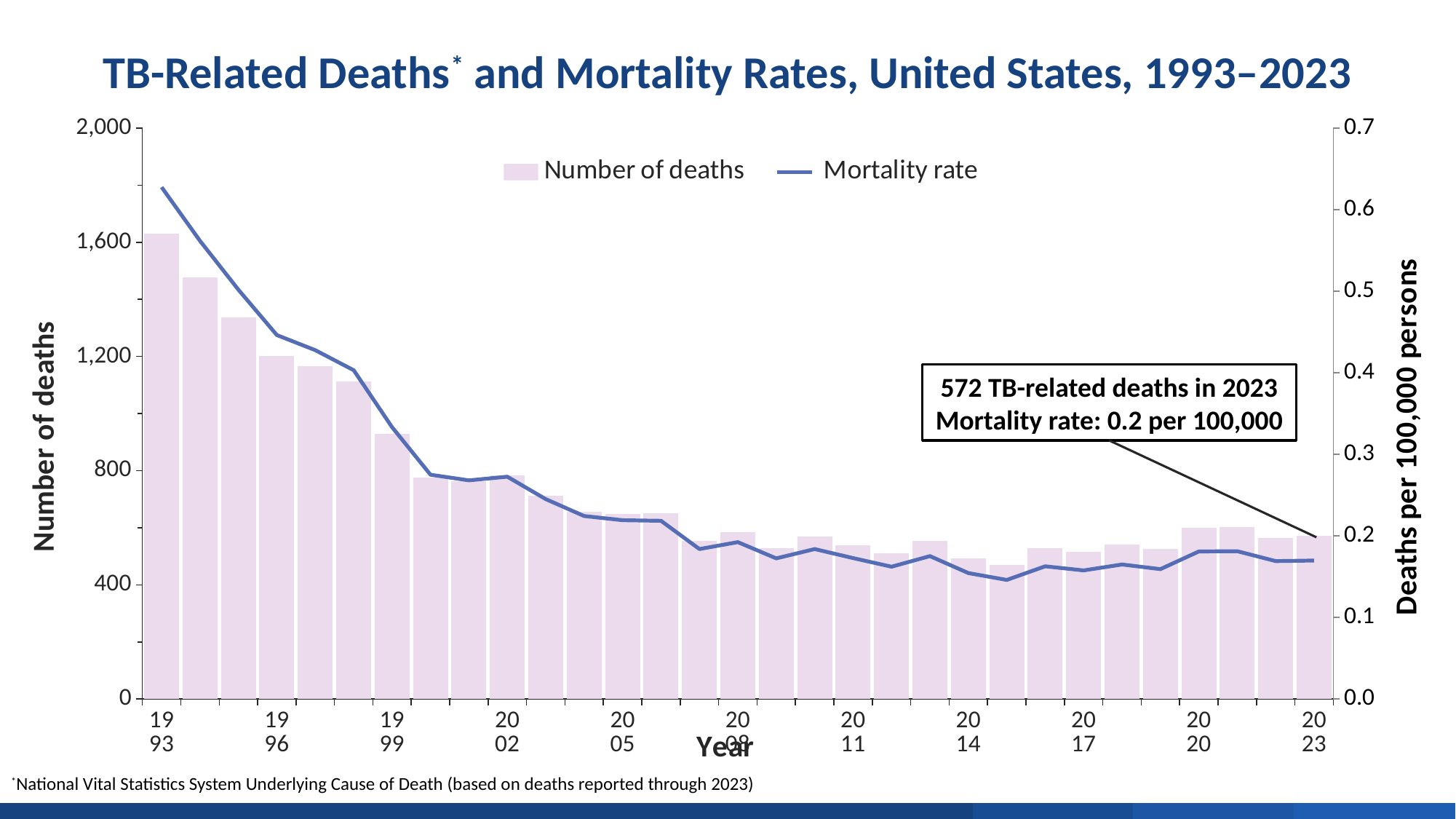
What is the title of the right-hand vertical axis? Deaths per 100,000 persons What was the TB mortality rate in 2023? 0.2 per 100,000 Which year has the highest number of TB-related deaths? 1993 Is the number of deaths in 2005 greater or less than 800? less Does the number of TB-related deaths generally rise or fall from 1993 to 2023? Fall Is the mortality rate in 1993 greater or less than 0.5? greater What kind of chart is shown on the slide? A bar chart combined with a line chart Is the number of deaths in 1993 greater or less than 1,200? greater How many series does the legend list? 2 Which year had more TB-related deaths, 1993 or 2023? 1993 What are the two entries in the chart legend? Number of deaths; Mortality rate How many TB-related deaths were reported in 2023? 572